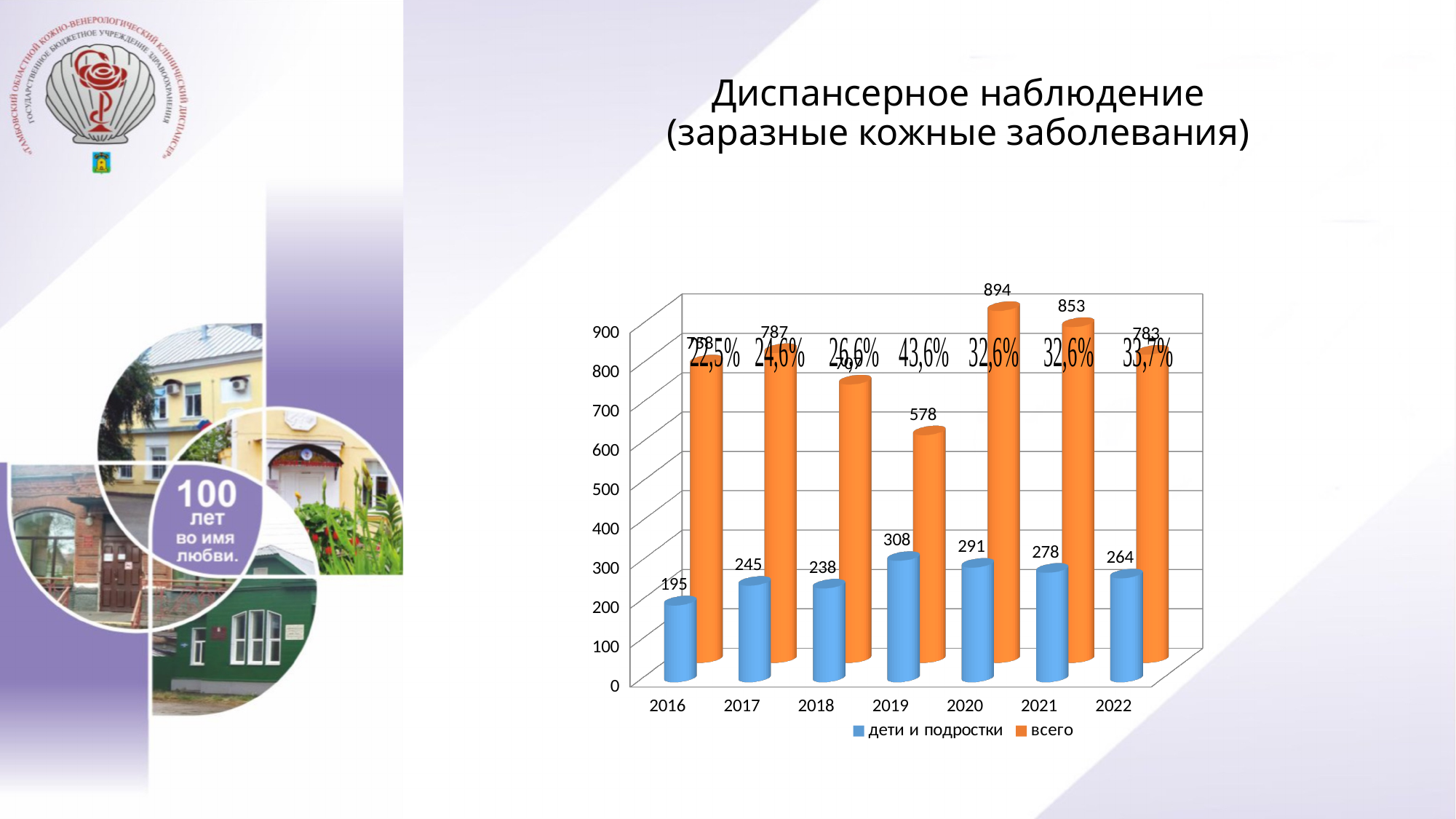
In which year is the дети и подростки series highest? 2019 What is the value for всего in 2020? 894 What is the value for дети и подростки in 2019? 308 How many years are shown on the x axis? 7 Which year has the larger всего value, 2021 or 2022? 2021 In which year is the дети и подростки series lowest? 2016 What is the difference between the всего values for 2020 and 2021? 41 In which year is the всего series highest? 2020 What is the value for всего in 2022? 783 In which year is the всего series lowest? 2019 How many series does the legend list? 2